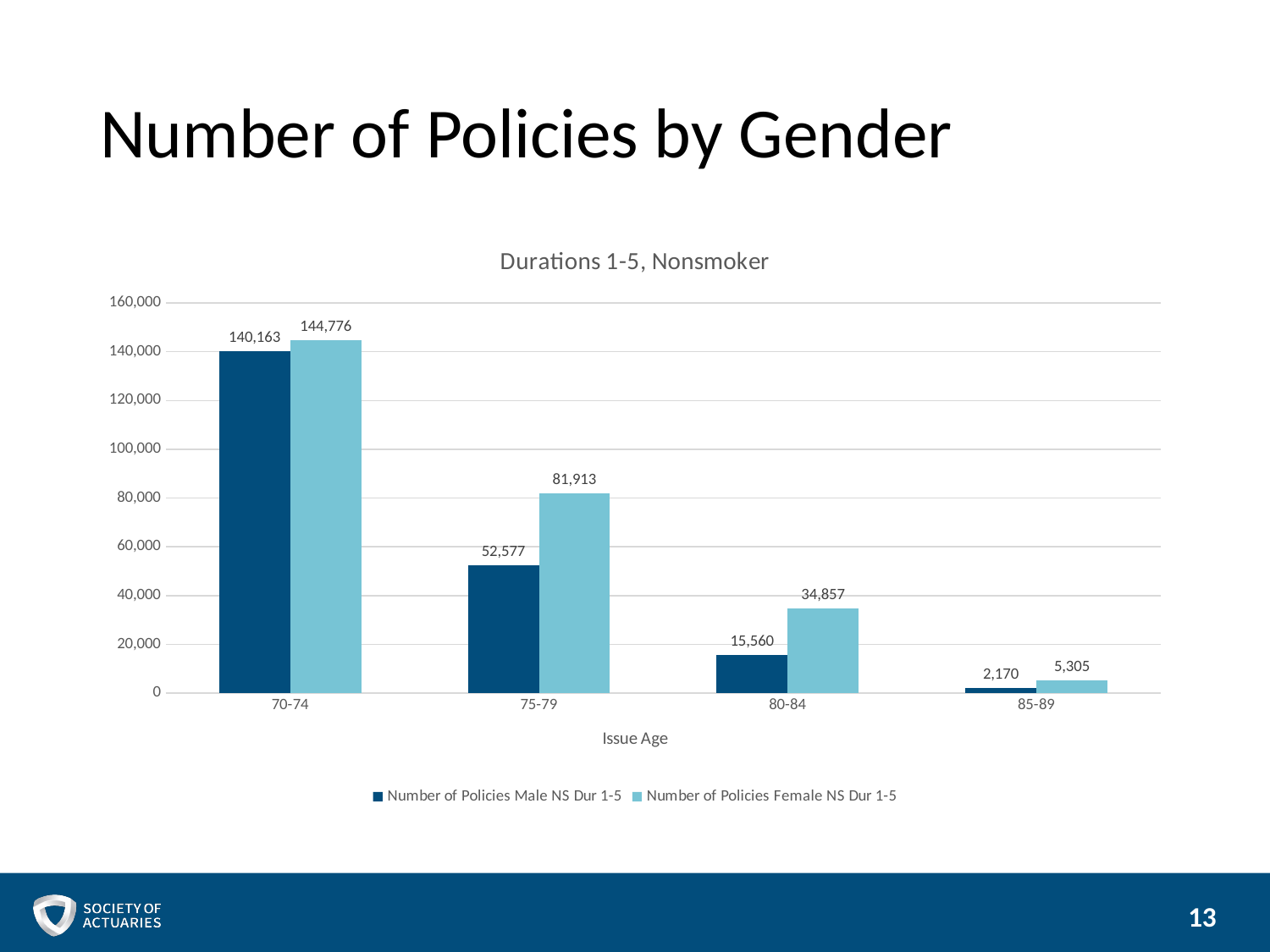
Which issue age group has the highest number of policies for Female NS Dur 1-5? 70-74 Which issue age group has the lowest number of policies for Male NS Dur 1-5? 85-89 At issue age 80-84, which is larger: the Male NS Dur 1-5 or the Female NS Dur 1-5 number of policies? Female NS Dur 1-5 How many issue age groups are shown on the x axis? 4 How many series does the legend list? 2 What is the number of policies for Female NS Dur 1-5 at issue age 80-84? 34,857 What is the number of policies for Male NS Dur 1-5 at issue age 70-74? 140,163 What is the number of policies for Male NS Dur 1-5 at issue age 85-89? 2,170 What kind of chart is shown on the slide? bar chart Do the Female NS Dur 1-5 values rise or fall as issue age increases along the x axis? fall Is the number of policies for Male NS Dur 1-5 at issue age 75-79 greater or less than 60,000? less What is the difference between the Female and Male NS Dur 1-5 policy counts at issue age 75-79? 29,336